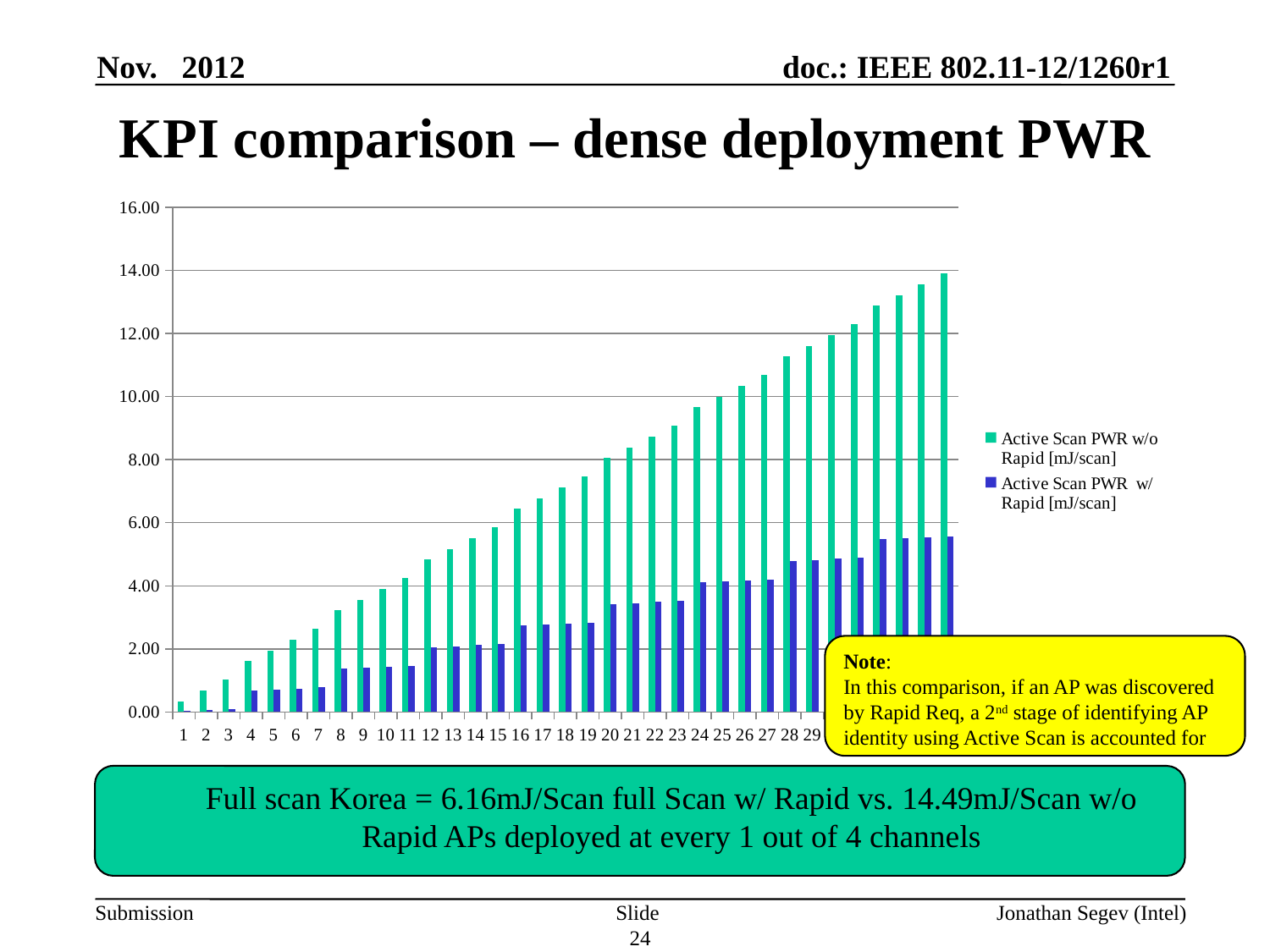
Is the value for 'Active Scan PWR w/o Rapid [mJ/scan]' at category 29 greater or less than 10.00? greater What kind of chart is shown on the slide? bar chart How many series does the chart legend list? 2 Is the value for 'Active Scan PWR w/o Rapid [mJ/scan]' at category 24 greater or less than 8.00? greater At category 25, which series has the larger value: 'Active Scan PWR w/o Rapid' or 'Active Scan PWR w/ Rapid'? Active Scan PWR w/o Rapid Which category has the lowest value for 'Active Scan PWR w/o Rapid [mJ/scan]'? 1 Is the value for 'Active Scan PWR w/o Rapid [mJ/scan]' at category 1 greater or less than 2.00? less Which colour represents the 'Active Scan PWR w/ Rapid [mJ/scan]' series? blue Do the values of the 'Active Scan PWR w/o Rapid [mJ/scan]' series rise or fall as the category number increases along the x axis? rise What are the two series named in the chart legend? Active Scan PWR w/o Rapid [mJ/scan] and Active Scan PWR w/ Rapid [mJ/scan]